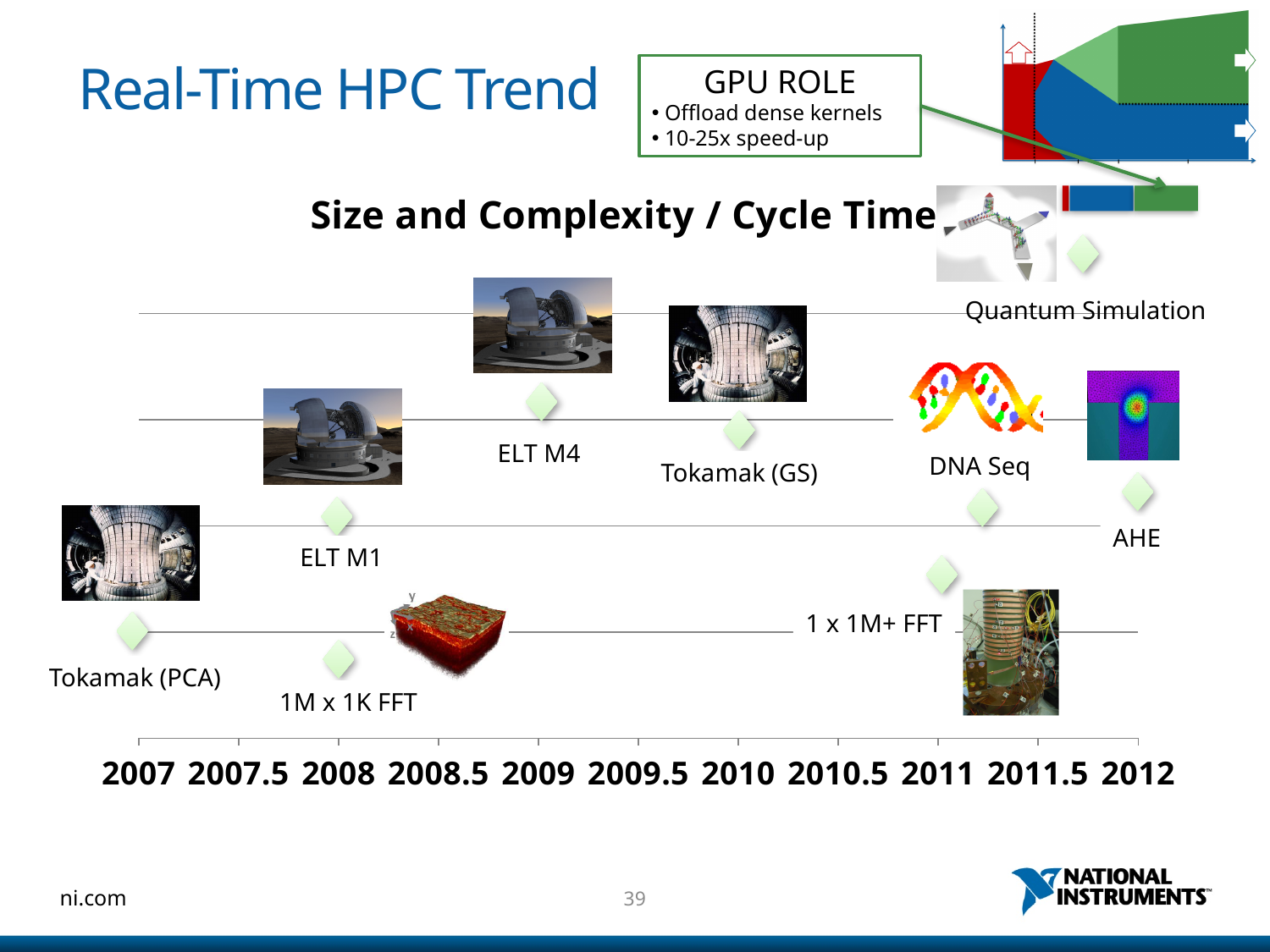
What year on the x axis does the AHE point sit at? 2012 Do the plotted points generally rise or fall as the years increase along the x axis? rise What year on the x axis does the Tokamak (PCA) point sit at? 2007 What year on the x axis does the Tokamak (GS) point sit at? 2010 What kind of chart is shown on the slide? scatter chart What is the title of the chart? Size and Complexity / Cycle Time What is the first year label and the last year label on the x axis? 2007 and 2012 Is the DNA Seq point positioned before or after 2010.5 on the x axis? after Which point is plotted higher on the chart, ELT M1 or ELT M4? ELT M4 Which labeled point is plotted highest on the chart? Quantum Simulation What year on the x axis does the ELT M4 point sit at? 2009 How many labeled data points are plotted on the chart? 9